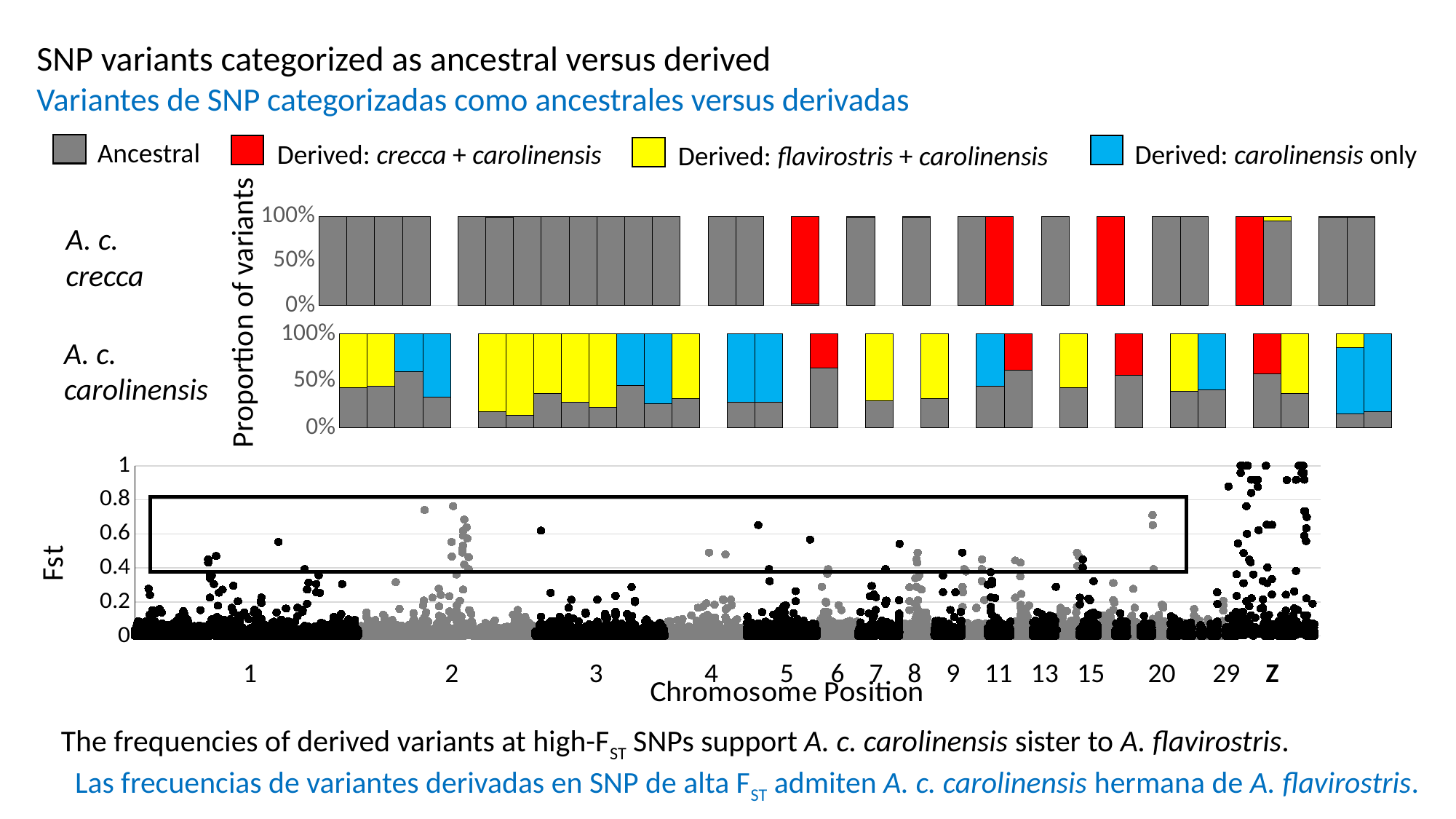
In the A. c. carolinensis bar chart, is the Ancestral proportion of the first (leftmost) bar greater or less than 50%? less In the bottom Fst chart, which chromosome has the highest Fst values? Z In the bottom Fst chart, is the highest Fst value on chromosome Z greater or less than 0.8? greater In the bottom Fst chart, what is the maximum value shown on the Fst axis? 1 In the A. c. crecca bar chart, what is the highest value shown on the y-axis? 100% In the legend, which colour represents Ancestral variants? Gray How many entries does the legend at the top of the slide list? 4 In the bottom Fst chart, is the highest Fst value on chromosome 1 greater or less than 0.6? less What kind of chart is the bottom Fst panel? Scatter plot What kind of chart is the A. c. crecca panel? Stacked bar chart What is the x-axis label of the bottom Fst chart? Chromosome Position